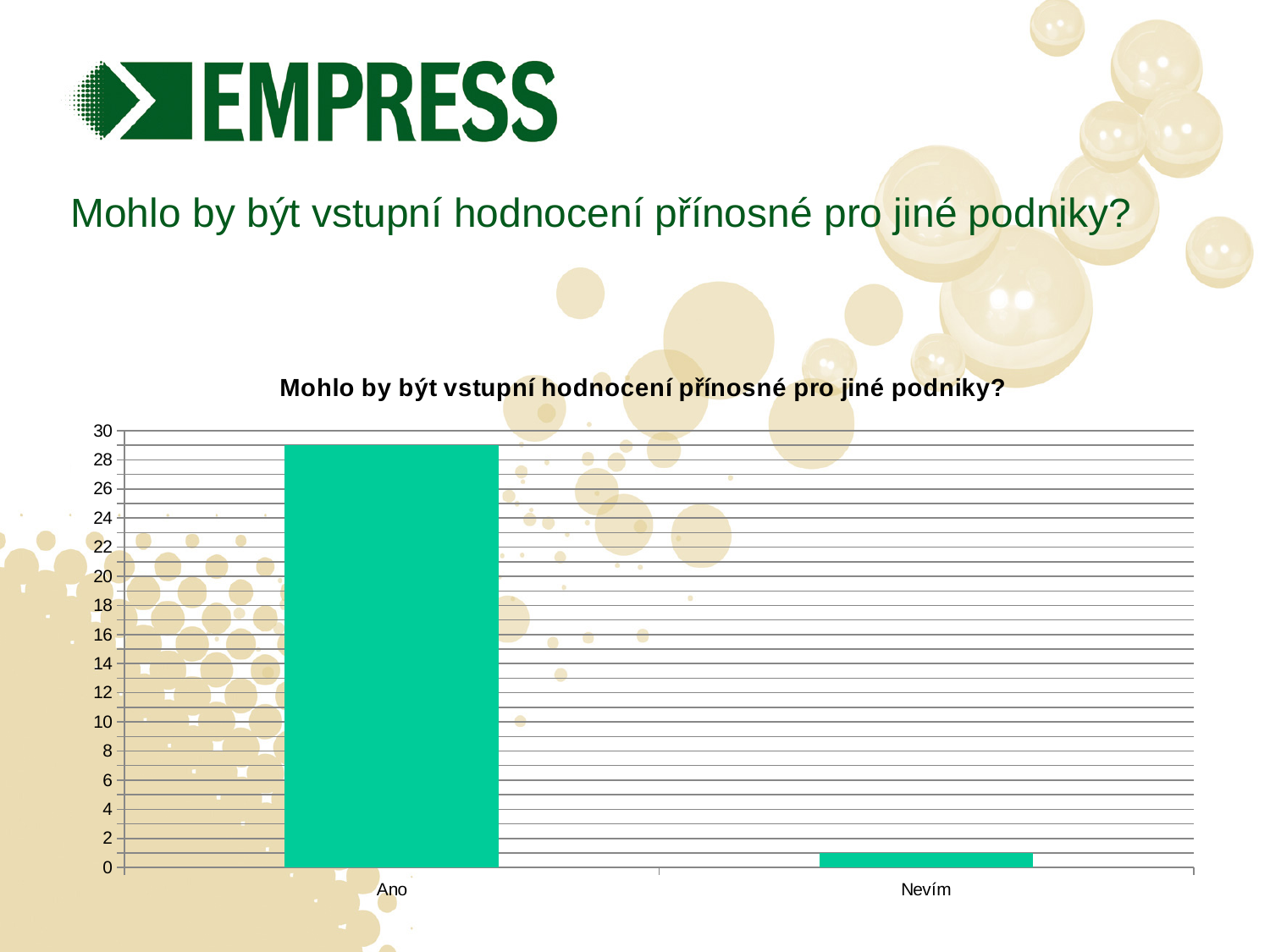
Which is larger, the value for Ano or the value for Nevím? Ano How many categories are shown on the x axis of the chart? 2 What is the maximum value shown on the vertical axis of the chart? 30 Which category has the lowest value in the chart? Nevím Do the values fall or rise from Ano to Nevím along the x axis? fall Is the value for Nevím greater or less than 4? less What is the title of the chart? Mohlo by být vstupní hodnocení přínosné pro jiné podniky? Is the value for Ano greater or less than 20? greater What type of chart is shown on the slide? bar chart Which category has the highest value in the chart? Ano Is the value for Ano greater or less than 26? greater